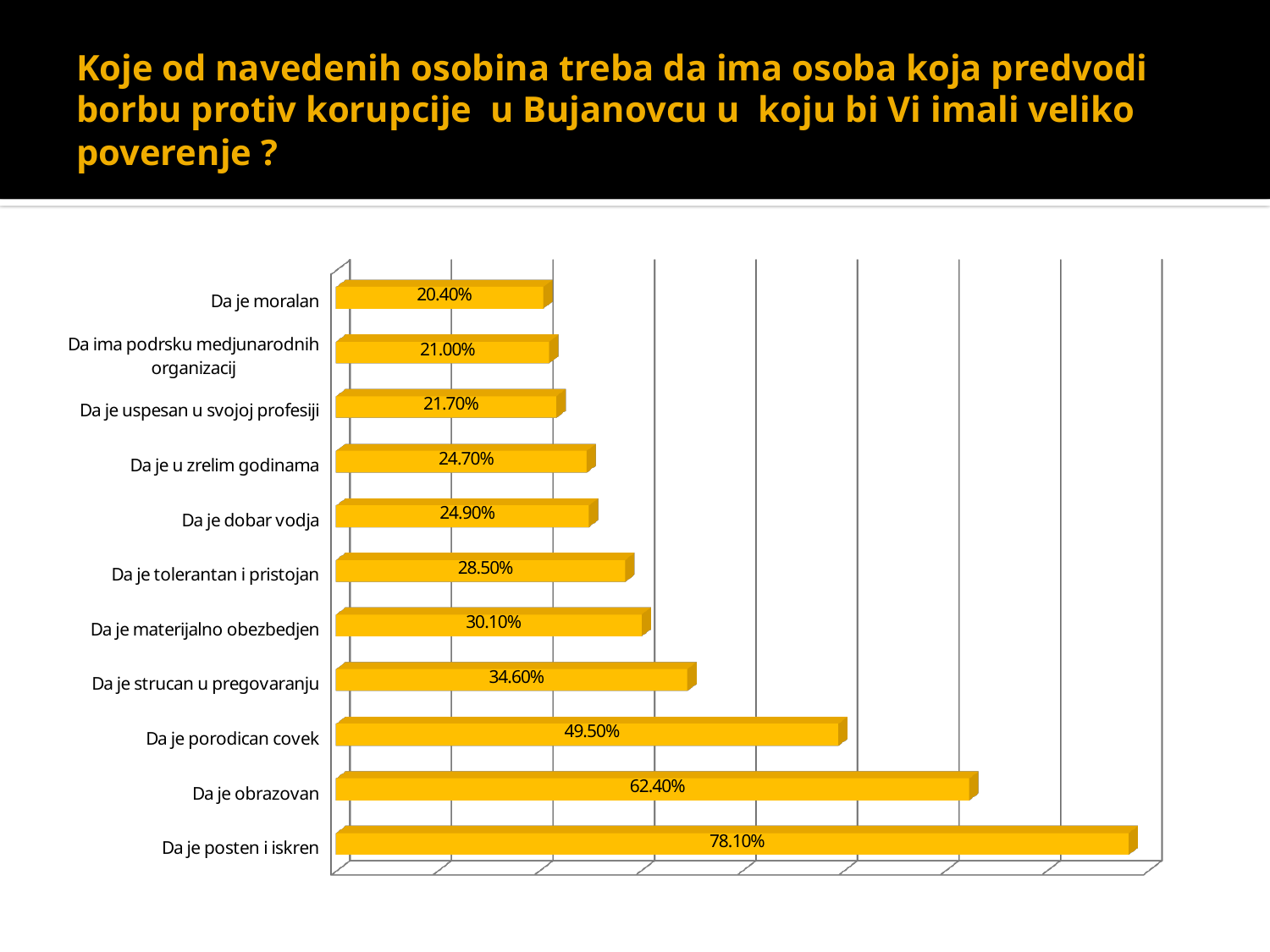
What is the value for "Da je obrazovan"? 62.40% What is the value for "Da je u zrelim godinama"? 24.70% What is the difference between the values for "Da je strucan u pregovaranju" and "Da je materijalno obezbedjen"? 4.50% Which category has the lowest value? Da je moralan How many categories are shown in the chart? 11 What is the value for "Da je porodican covek"? 49.50% What is the value for "Da je posten i iskren"? 78.10% Which is larger, the value for "Da je tolerantan i pristojan" or the value for "Da je dobar vodja"? Da je tolerantan i pristojan What is the difference between the values for "Da je posten i iskren" and "Da je obrazovan"? 15.70% Which category has the highest value? Da je posten i iskren What is the value for "Da ima podrsku medjunarodnih organizacij"? 21.00% What kind of chart is shown on the slide? Bar chart